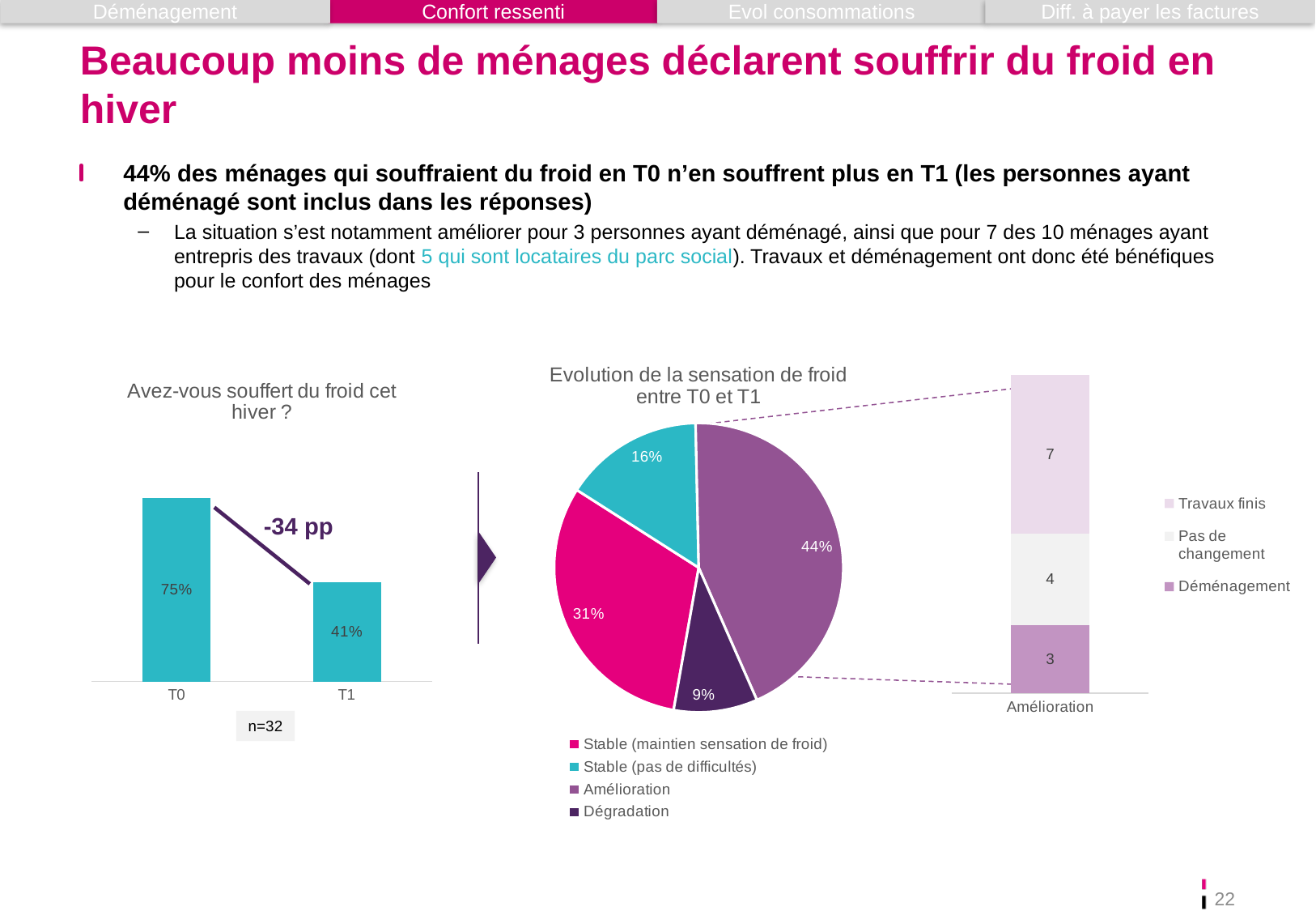
In the pie chart 'Evolution de la sensation de froid entre T0 et T1', which category has the smallest slice? Dégradation In the chart 'Avez-vous souffert du froid cet hiver ?', what is the value for T1? 41% In the pie chart 'Evolution de la sensation de froid entre T0 et T1', which category has the largest slice? Amélioration In the pie chart 'Evolution de la sensation de froid entre T0 et T1', what is the value for Dégradation? 9% In the chart 'Avez-vous souffert du froid cet hiver ?', do the values rise or fall from T0 to T1? fall In the chart 'Avez-vous souffert du froid cet hiver ?', what is the difference between T0 and T1? 34 pp In the chart 'Avez-vous souffert du froid cet hiver ?', what is the value for T0? 75% In the stacked bar chart on the right labelled 'Amélioration', what is the total of the stacked bar? 14 In the stacked bar chart on the right labelled 'Amélioration', what is the value for Travaux finis? 7 What kind of chart is 'Avez-vous souffert du froid cet hiver ?'? bar chart How many entries does the legend of the pie chart 'Evolution de la sensation de froid entre T0 et T1' list? 4 In the pie chart 'Evolution de la sensation de froid entre T0 et T1', what share is Amélioration? 44%